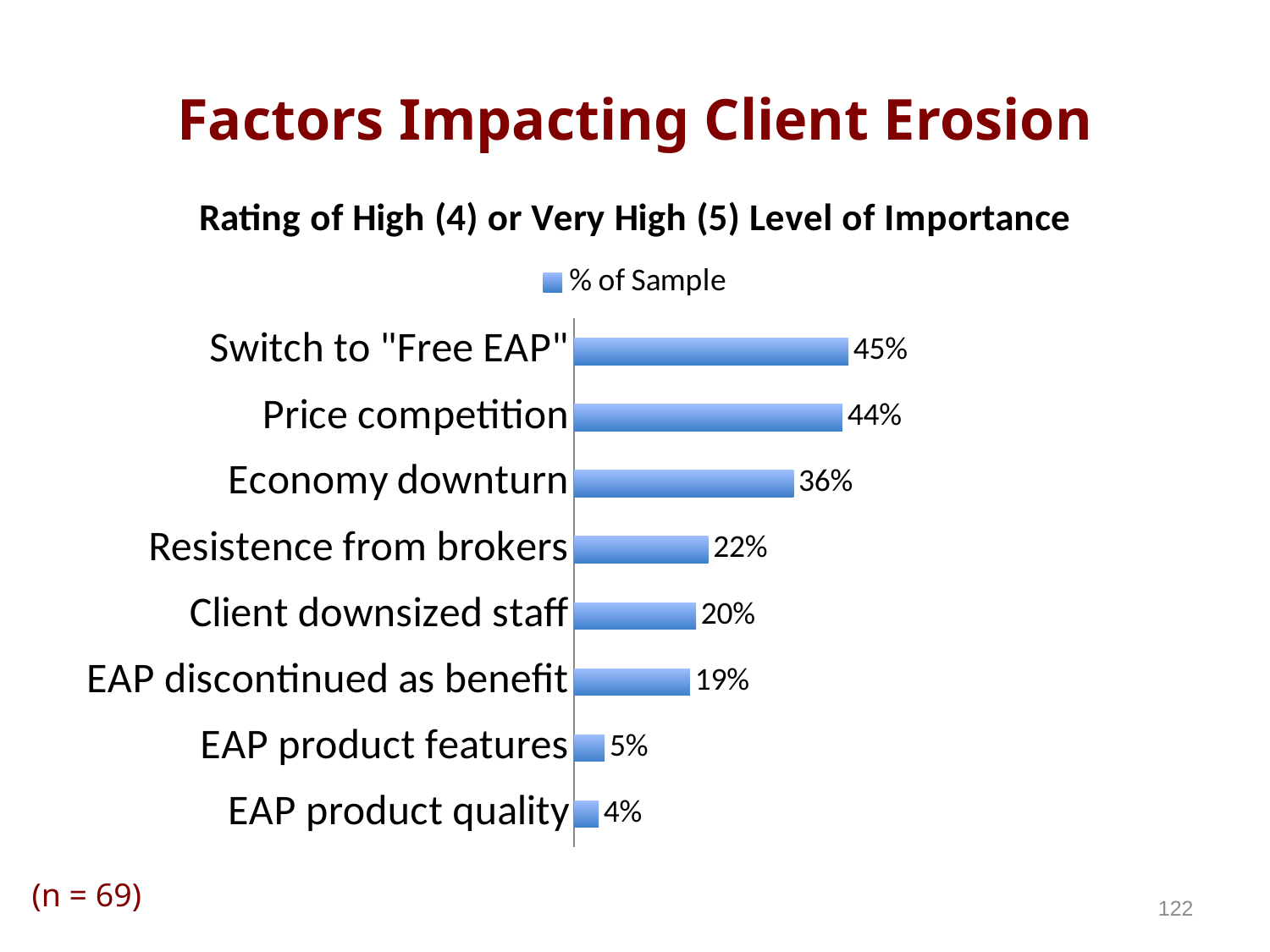
Which factor has the lowest value? EAP product quality What is the difference between Client downsized staff and EAP product features? 15% What kind of chart is shown? Bar chart How many factors are shown in the chart? 8 What is the value for EAP discontinued as benefit? 19% What is the value for Switch to "Free EAP"? 45% Which is larger, Economy downturn or Client downsized staff? Economy downturn What is the difference between Price competition and Resistence from brokers? 22% What is the value for Economy downturn? 36% What is the legend entry for the series? % of Sample How many series does the legend list? 1 Which factor has the highest value? Switch to "Free EAP"